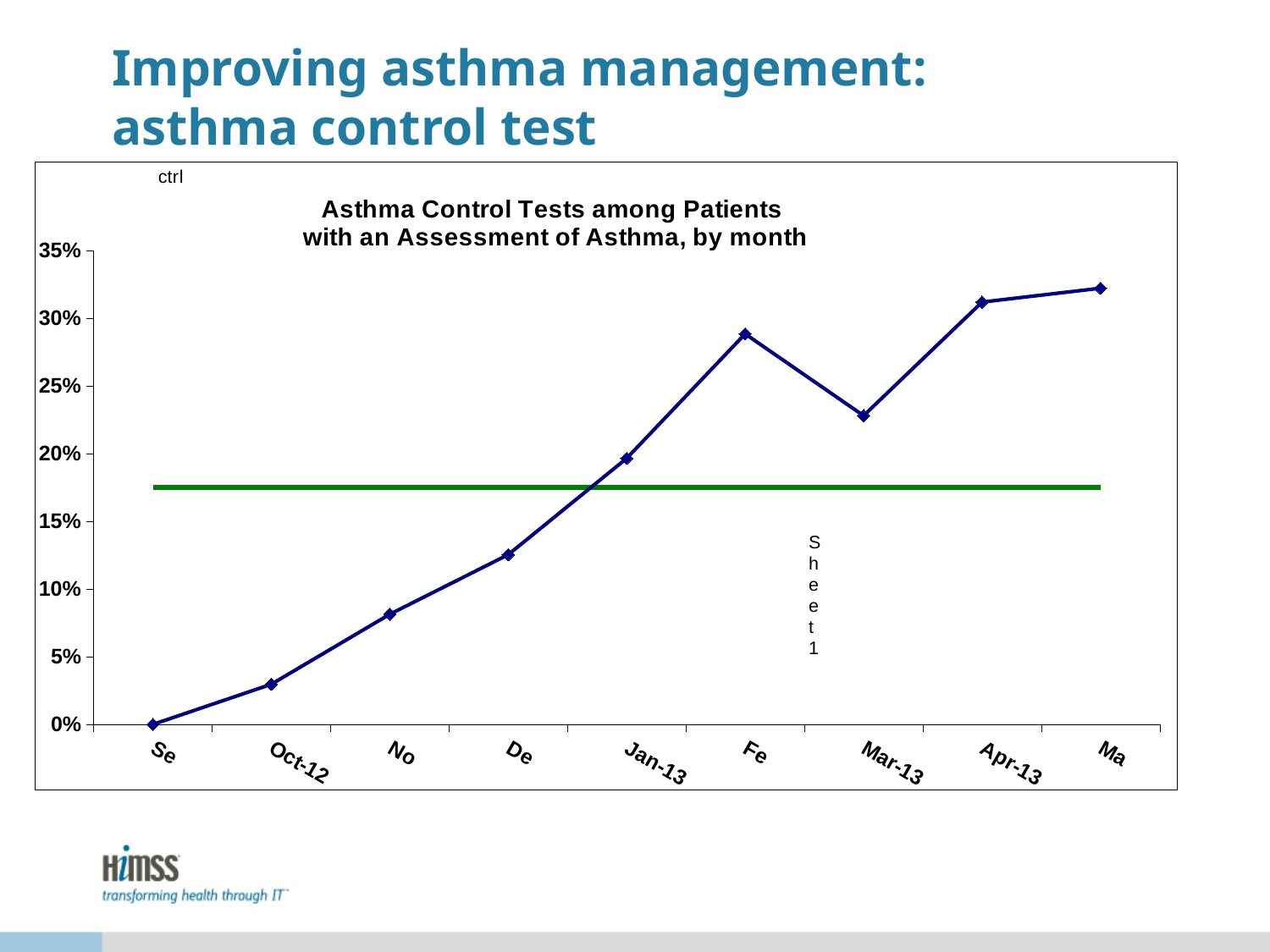
What is the value for Se? 0% Which is larger, the value for Jan-13 or the value for Apr-13? Apr-13 What kind of chart is shown on the slide? line chart How many months are plotted on the x axis? 9 Which month has the lowest value? Se Do the values generally rise or fall from Se to Ma? rise Is the value for Oct-12 greater or less than 5%? less Is the value for De greater or less than 10%? greater Which is larger, the value for Fe or the value for Mar-13? Fe Is the value for Mar-13 greater or less than 25%? less What is the title of the chart? Asthma Control Tests among Patients with an Assessment of Asthma, by month